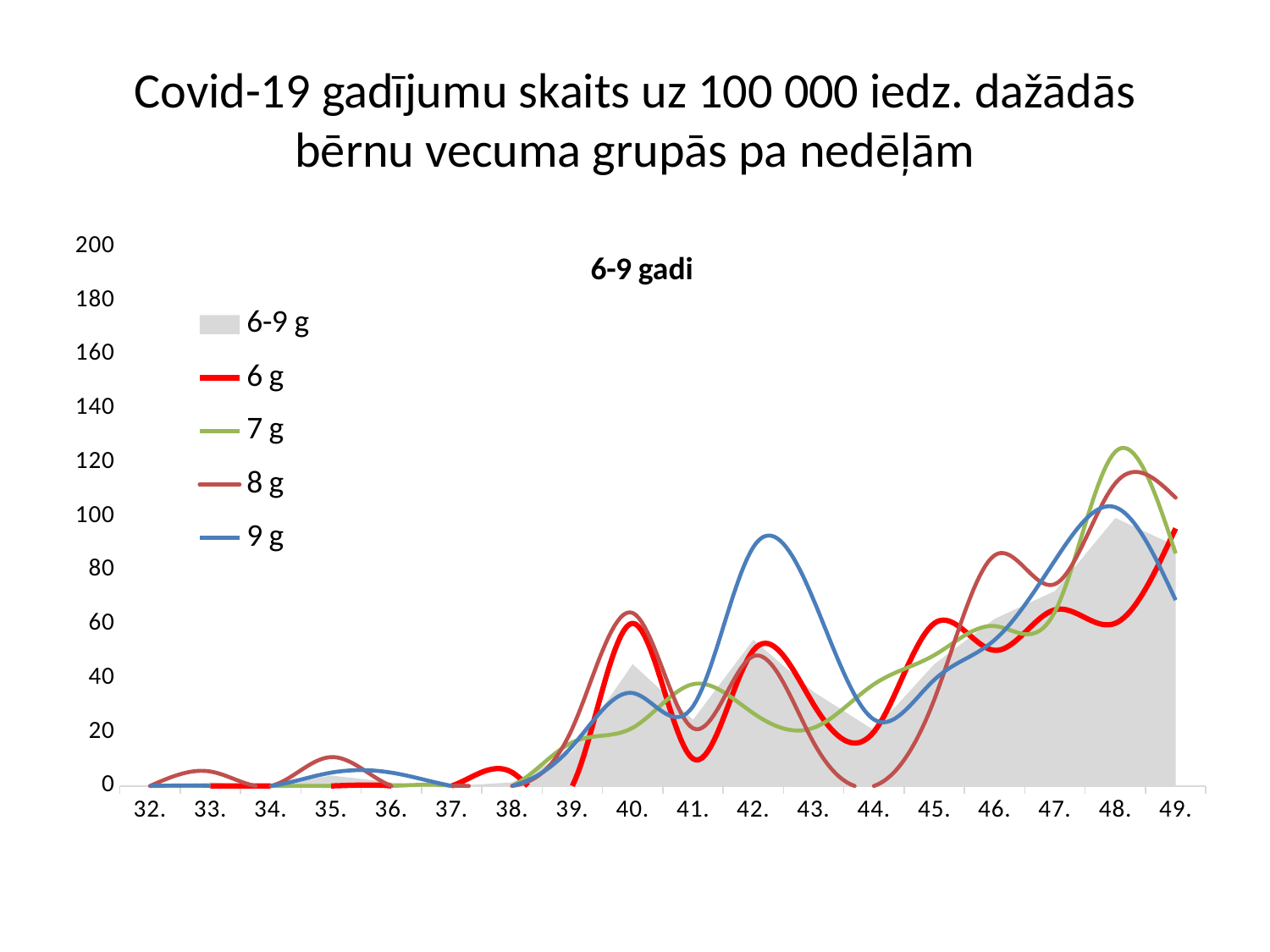
In week 48., which is larger, the value for 7 g or the value for 6 g? 7 g Is the value for 6 g in week 41. greater or less than 20? less Is the value for 6 g in week 40. greater or less than 40? greater What is the title printed inside the chart area? 6-9 gadi How many weeks are shown on the x axis? 18 Is the value for 7 g in week 48. greater or less than 100? greater Which series is drawn as a shaded grey area? 6-9 g Which series has the highest value in week 42.? 9 g Does the 6-9 g series rise or fall from week 44. to week 48.? rise What kind of chart is shown on the slide? combination area and line chart How many series does the legend list? 5